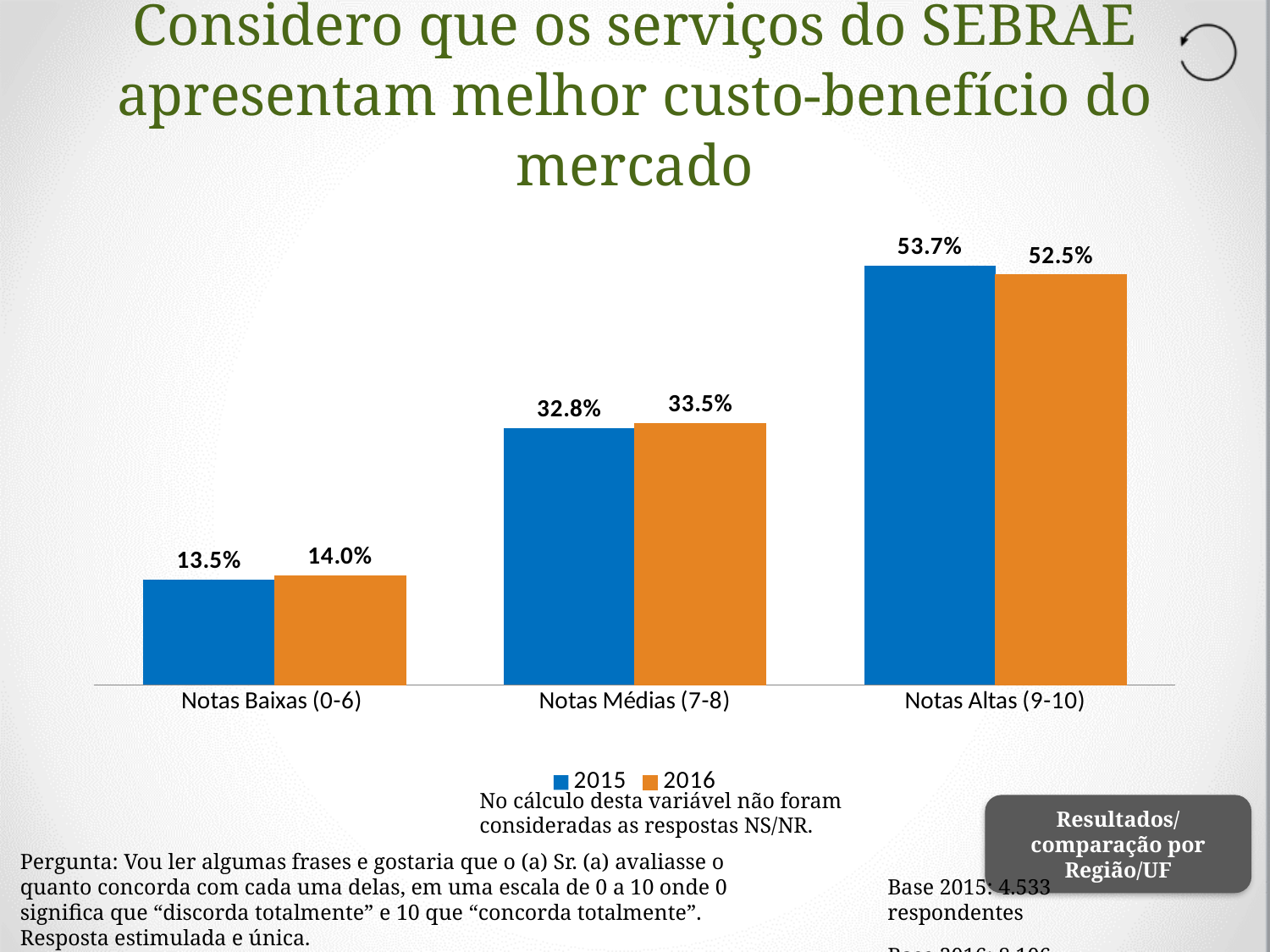
How many categories are shown on the x axis? 3 Which category has the highest value for the 2016 series? Notas Altas (9-10) Which category has the lowest value for the 2015 series? Notas Baixas (0-6) What is the value for Notas Altas (9-10) in 2016? 52.5% How many series does the legend list? 2 What is the difference between the 2016 values for Notas Médias (7-8) and Notas Baixas (0-6)? 19.5% What is the value for Notas Altas (9-10) in 2015? 53.7% Which is larger for Notas Médias (7-8): the 2015 value or the 2016 value? 2016 What is the value for Notas Baixas (0-6) in 2016? 14.0% What kind of chart is shown on the slide? Bar chart What is the difference between the 2015 and 2016 values for Notas Altas (9-10)? 1.2% What is the value for Notas Médias (7-8) in 2015? 32.8%